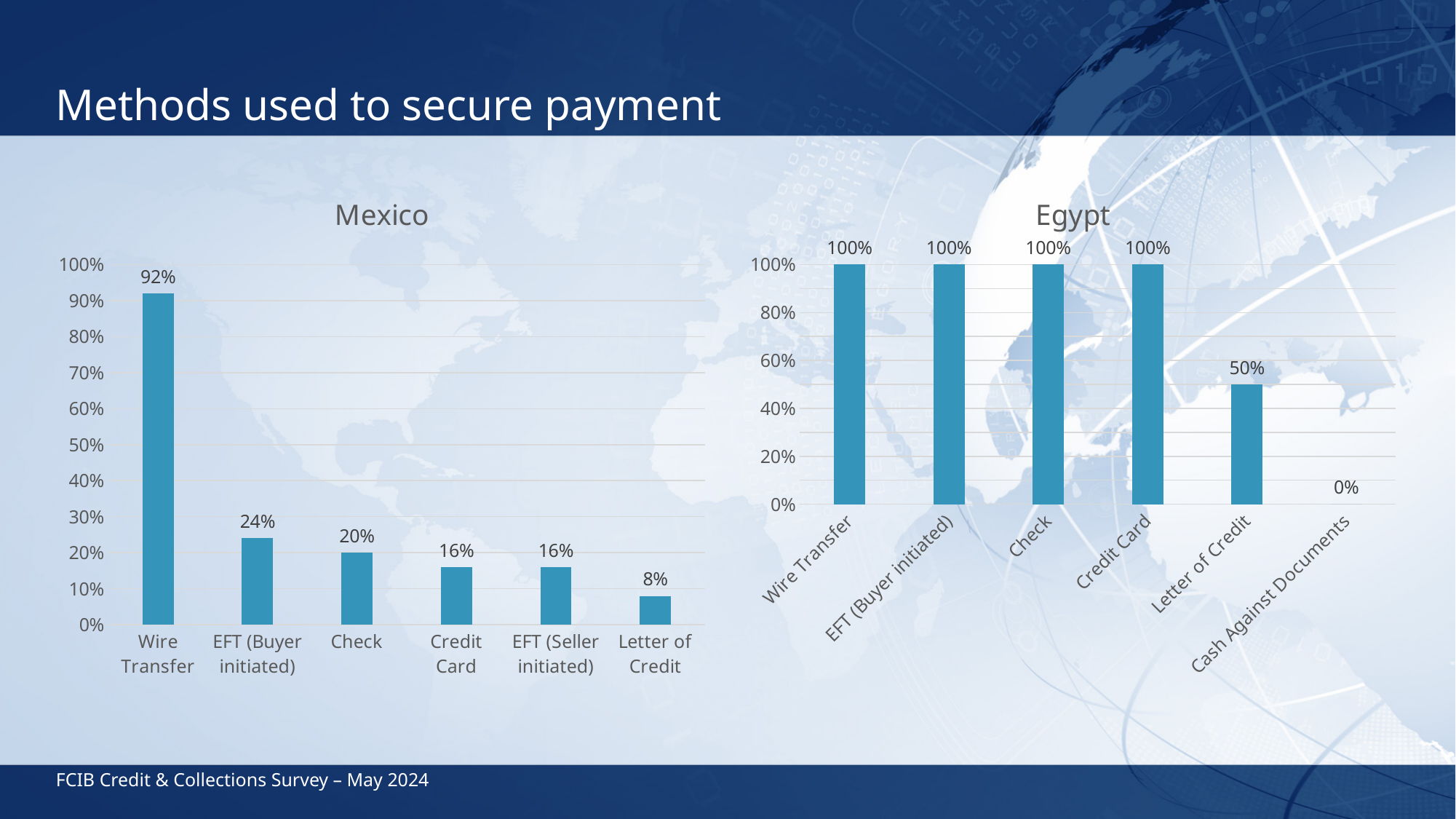
In the Mexico chart, what is the value for Check? 20% In the Egypt chart, what is the value for Cash Against Documents? 0% In the Mexico chart, what is the value for Wire Transfer? 92% In the Egypt chart, which is larger, Credit Card or Letter of Credit? Credit Card In the Mexico chart, how many categories are shown? 6 In the Egypt chart, which category has the lowest value? Cash Against Documents In the Mexico chart, what is the difference between Wire Transfer and EFT (Buyer initiated)? 68% What is the title of the chart on the right side of the slide? Egypt In the Egypt chart, what is the value for Letter of Credit? 50% What kind of chart is the Mexico chart? Bar chart In the Egypt chart, how many categories are shown? 6 In the Mexico chart, which category has the lowest value? Letter of Credit